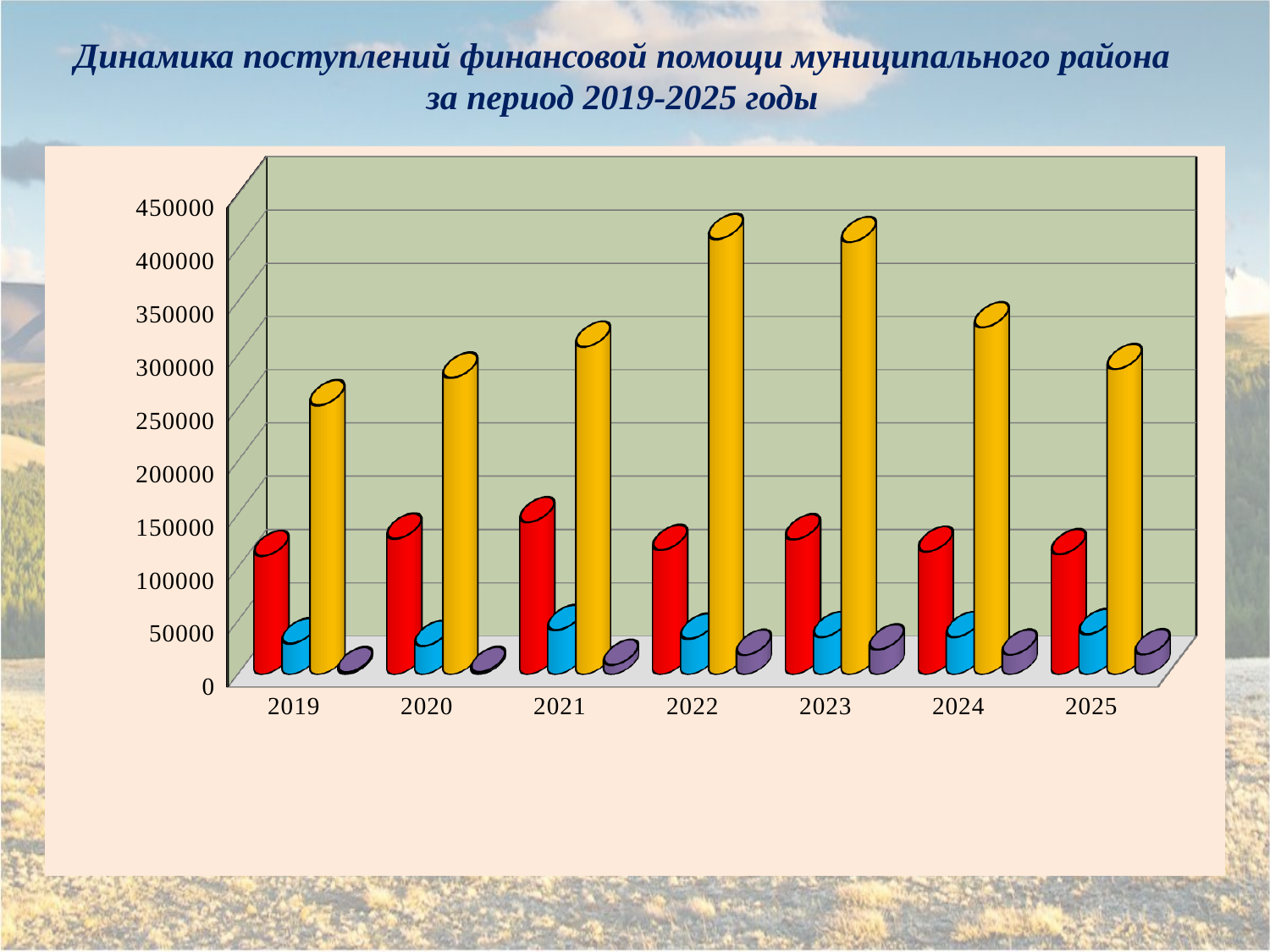
Is the blue bar for 2023 greater or less than 100000? less Do the yellow bars rise or fall from 2019 to 2022? rise What is the title of the slide? Динамика поступлений финансовой помощи муниципального района за период 2019-2025 годы Which year has the lowest yellow bar? 2019 Which year has the highest red bar? 2021 Is the yellow bar for 2022 greater or less than 400000? greater Is the red bar for 2021 greater or less than 100000? greater What kind of chart is shown on the slide? bar chart Which is larger, the yellow bar for 2022 or the yellow bar for 2019? 2022 How many bars are shown for each year in the chart? 4 How many years are shown on the x axis of the chart? 7